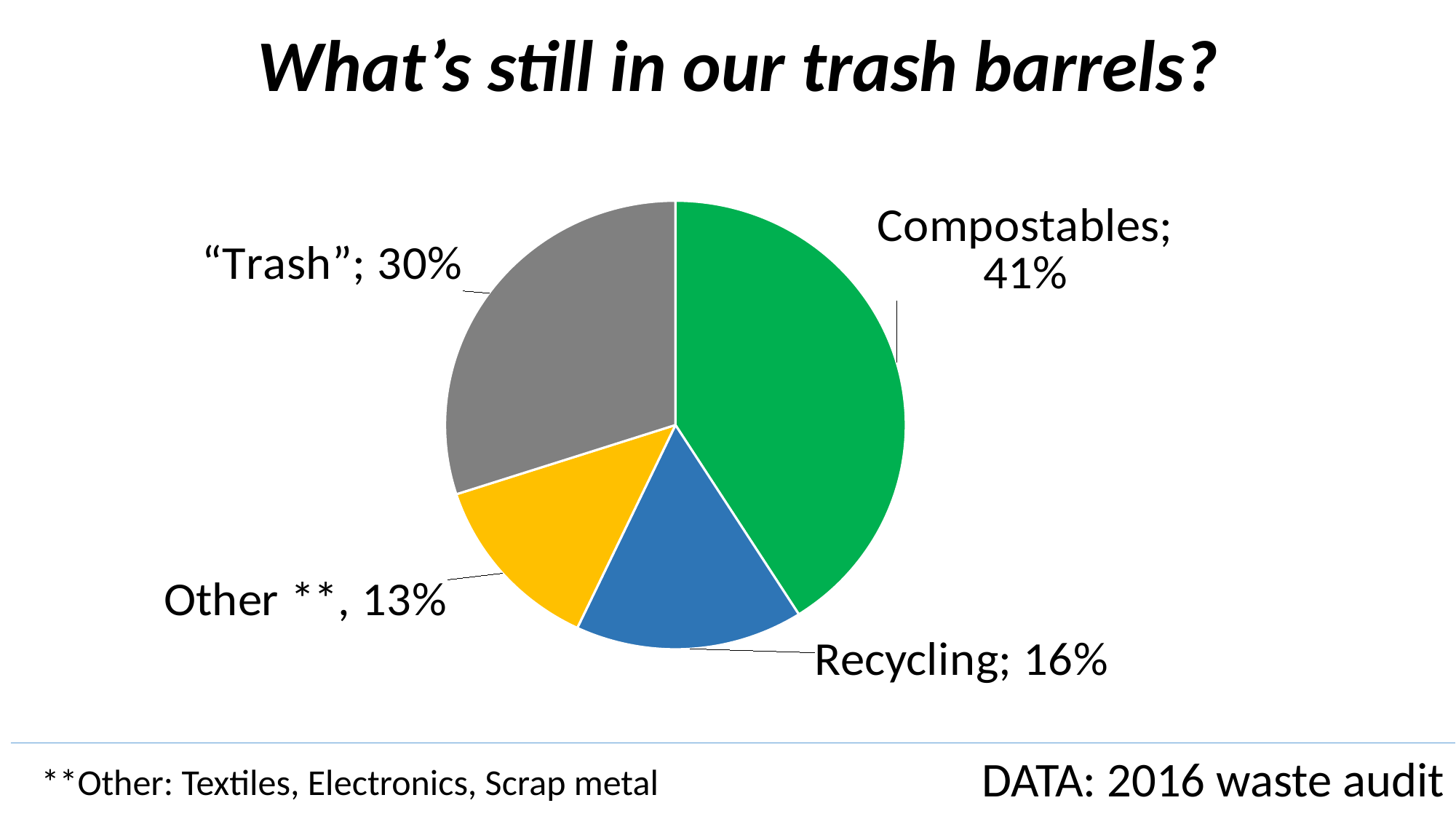
Which is larger, the Recycling slice or the "Trash" slice? "Trash" How many slices does the pie chart have? 4 Which category has the largest slice of the pie? Compostables What is the title of the slide containing the pie chart? What's still in our trash barrels? What is the difference in percentage points between Compostables and "Trash"? 11 Which category has the smallest slice of the pie? Other What is the difference in percentage points between Recycling and Other? 3 What share of the pie is Other? 13% What share of the pie is "Trash"? 30% What share of the pie is Compostables? 41% What share of the pie is Recycling? 16% What kind of chart is shown on the slide? pie chart